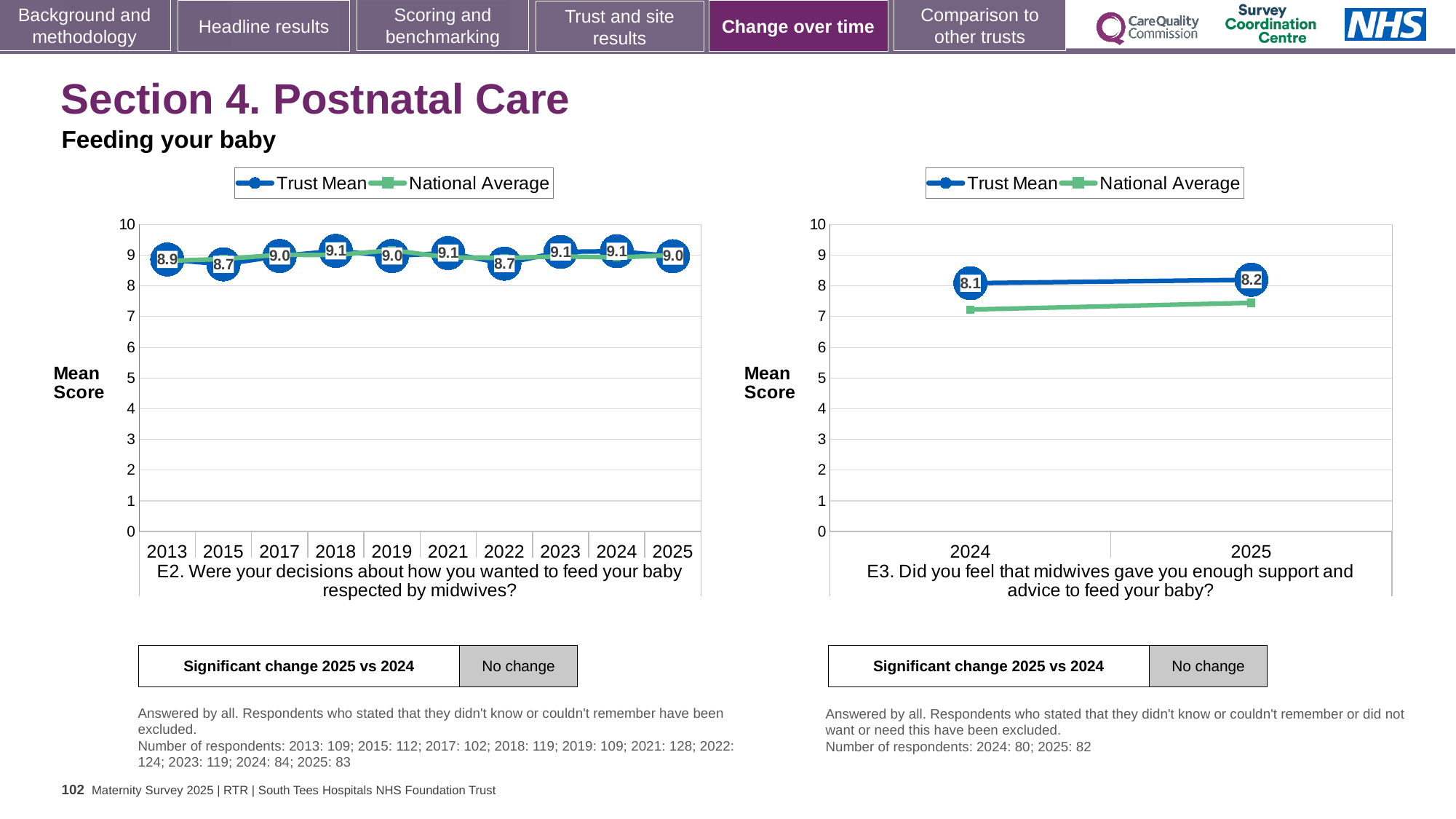
In the right chart (E3), what is the Trust Mean for 2024? 8.1 In the right chart (E3), is the National Average for 2024 greater or less than 8? less In the left chart (E2), what is the Trust Mean for 2025? 9.0 In the left chart (E2), how many years are plotted on the x axis? 10 In the left chart (E2), what is the Trust Mean for 2013? 8.9 In the left chart (E2), what is the difference between the Trust Mean for 2018 and 2015? 0.4 In the left chart (E2), what is the Trust Mean for 2022? 8.7 What type of chart is the left chart (E2)? Line chart In the right chart (E3), which year has the higher Trust Mean, 2024 or 2025? 2025 In the right chart (E3), what is the difference between the Trust Mean for 2025 and 2024? 0.1 In the right chart (E3), how many series does the legend list? 2 In the right chart (E3), what is the Trust Mean for 2025? 8.2